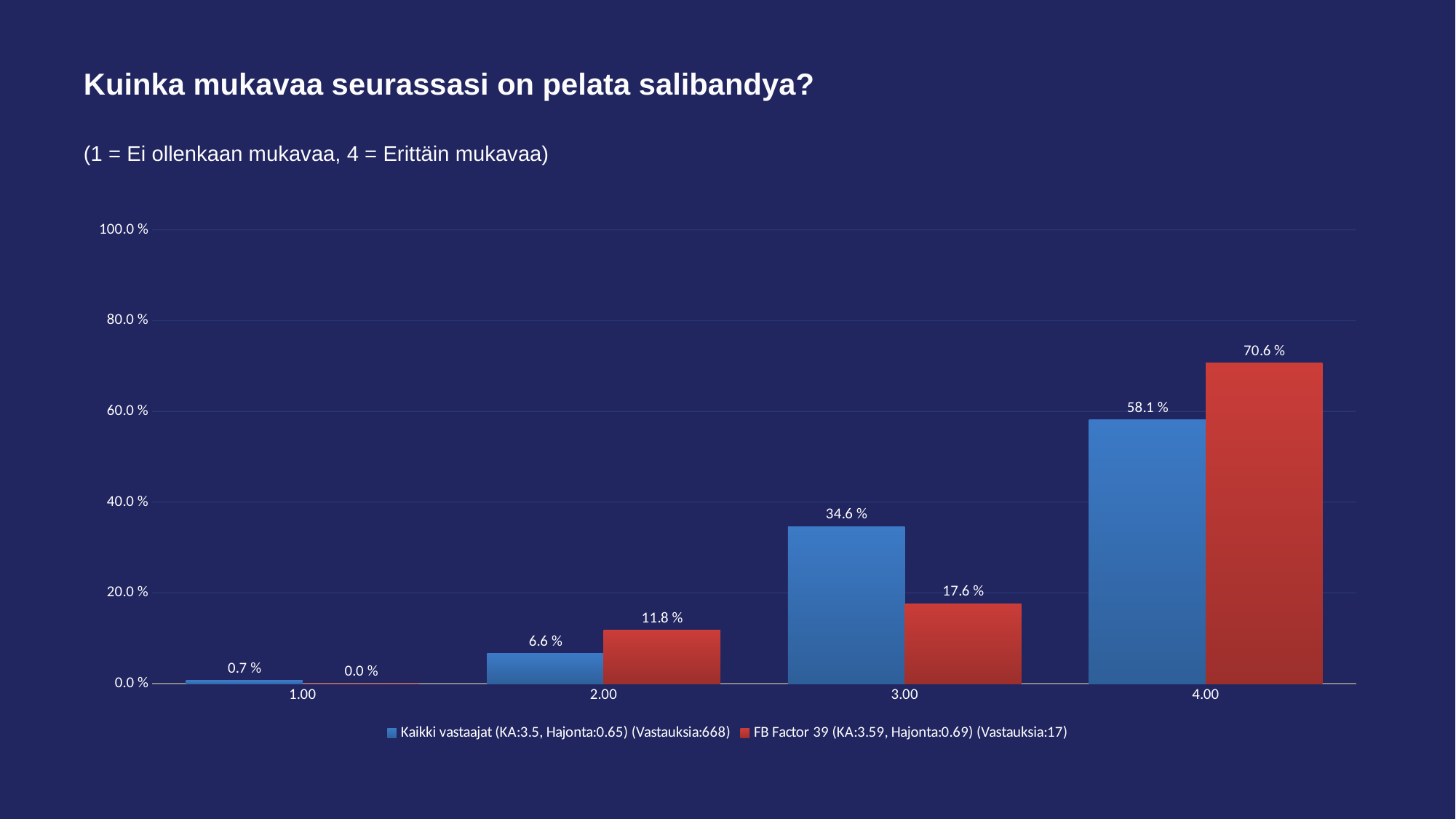
Do the values for Kaikki vastaajat rise or fall from category 1.00 to 4.00? Rise What is the value for FB Factor 39 at category 1.00? 0.0 % What is the value for Kaikki vastaajat at category 2.00? 6.6 % How many categories are shown on the x axis? 4 What is the value for FB Factor 39 at category 3.00? 17.6 % At category 3.00, which series has the larger value, Kaikki vastaajat or FB Factor 39? Kaikki vastaajat Which category has the lowest value for Kaikki vastaajat? 1.00 Which category has the highest value for FB Factor 39? 4.00 What is the value for Kaikki vastaajat at category 4.00? 58.1 % How many series does the legend list? 2 What kind of chart is shown on the slide? Bar chart What is the difference between the FB Factor 39 and Kaikki vastaajat values at category 4.00? 12.5 %